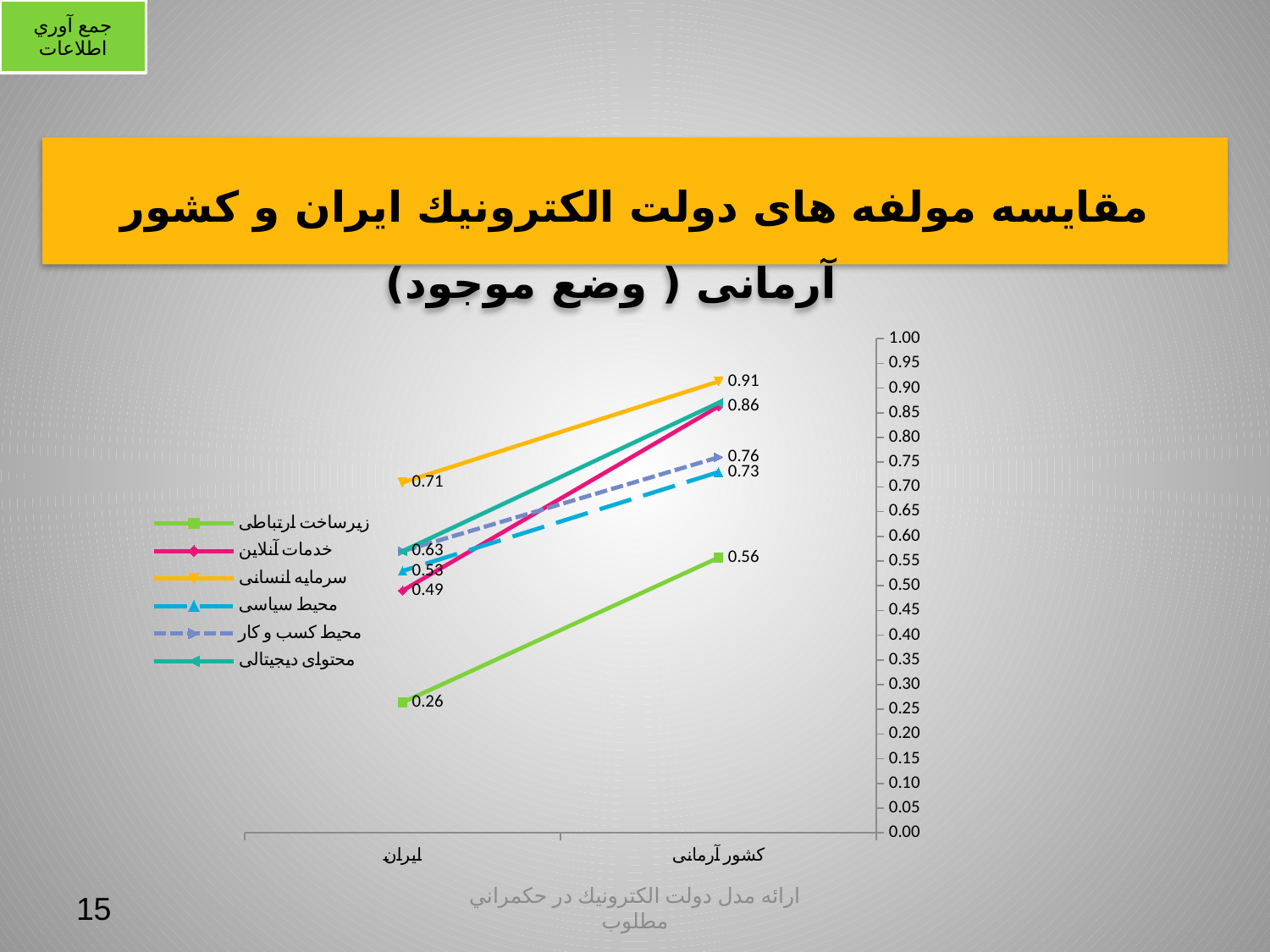
What is the value of محیط سیاسی for کشور آرمانی? 0.73 Which series has the lowest value for ایران? زیرساخت ارتباطی Which series has the highest value for کشور آرمانی? سرمایه انسانی What is the value of زیرساخت ارتباطی for کشور آرمانی? 0.56 What is the value of سرمایه انسانی for ایران? 0.71 What type of chart is shown on the slide? line chart How many categories are shown on the x axis? 2 What is the value of سرمایه انسانی for کشور آرمانی? 0.91 What is the value of زیرساخت ارتباطی for ایران? 0.26 How many series does the legend list? 6 What is the difference between the زیرساخت ارتباطی values for کشور آرمانی and ایران? 0.30 Do the series values rise or fall from ایران to کشور آرمانی? rise